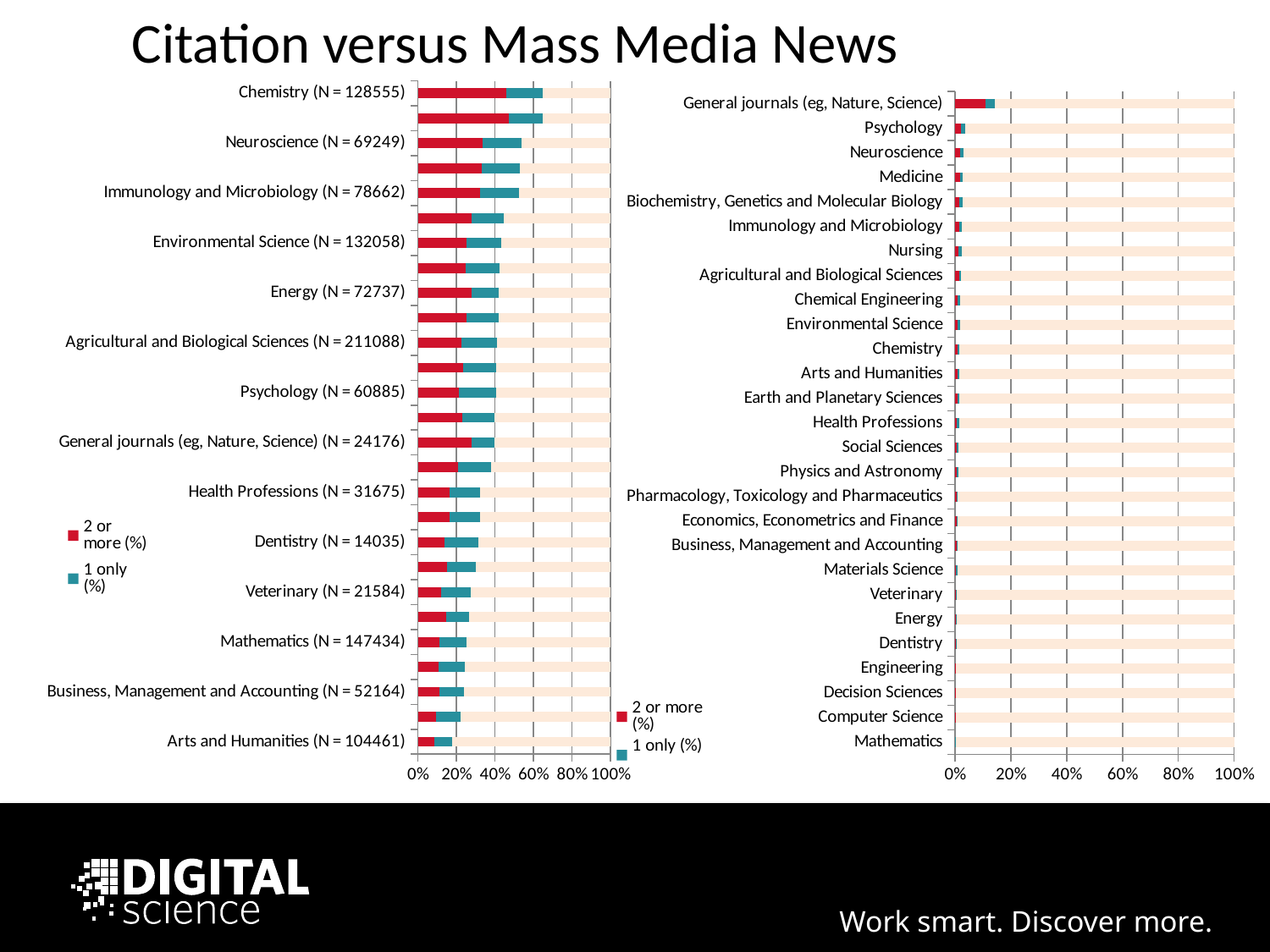
In the left-hand chart, is the total bar for Arts and Humanities (N = 104461) greater or less than 40%? less What are the two legend entries on the right-hand chart? 2 or more (%) and 1 only (%) In the left-hand chart, which labeled category has the shortest total bar? Arts and Humanities (N = 104461) In the left-hand chart, which labeled category has the longest total bar? Chemistry (N = 128555) What kind of chart is the left-hand chart on the slide? Stacked bar chart In the right-hand chart, is the total bar for General journals (eg, Nature, Science) greater or less than 20%? less What is the title of the slide containing the two charts? Citation versus Mass Media News In the right-hand chart, which category has the longest total bar? General journals (eg, Nature, Science) In the left-hand chart, is the total bar for Chemistry (N = 128555) greater or less than 40%? greater How many categories are listed on the right-hand chart? 27 How many series does the legend of the left-hand chart list? 2 In the right-hand chart, which has the larger total bar, General journals (eg, Nature, Science) or Mathematics? General journals (eg, Nature, Science)